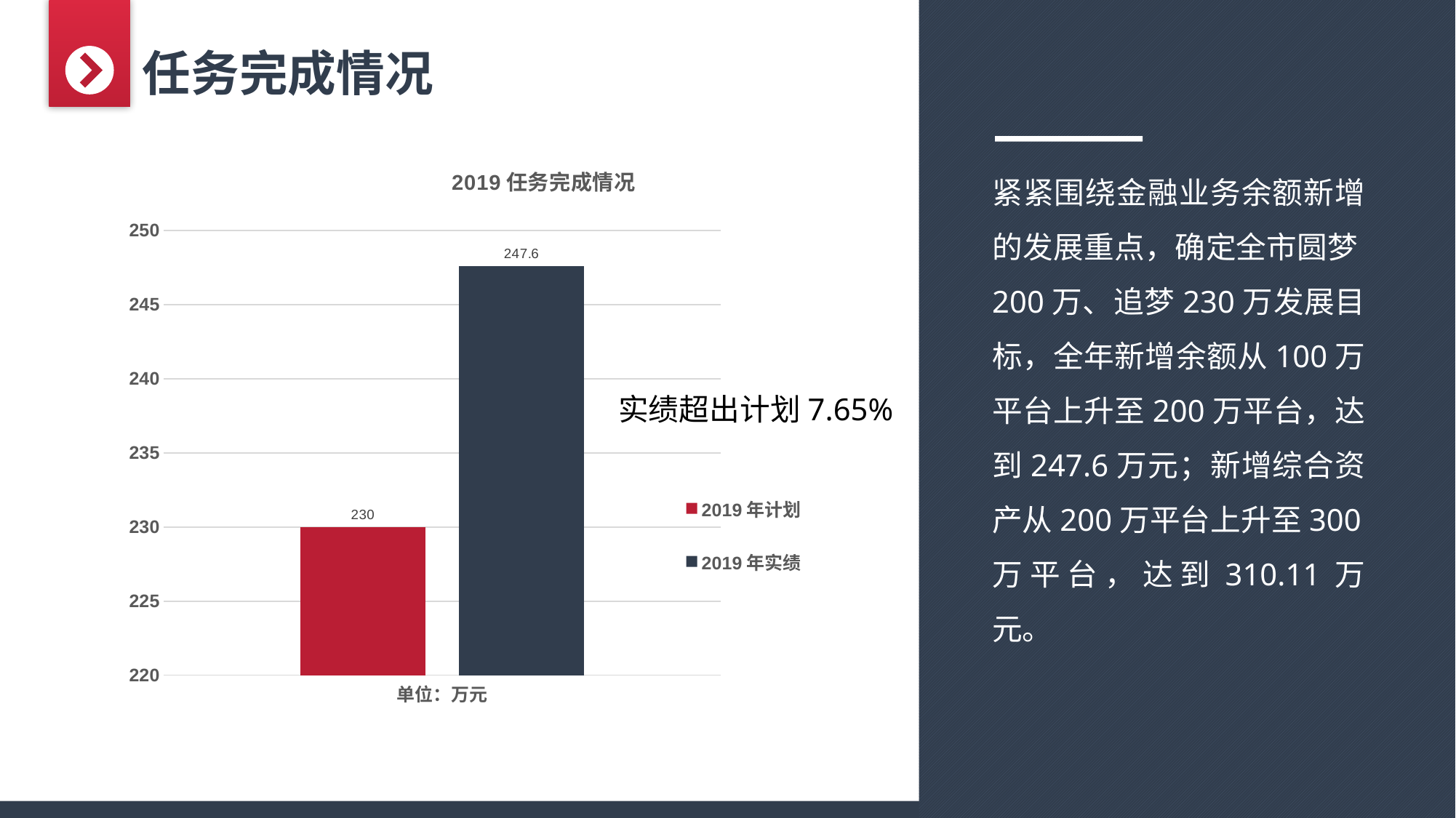
What colour is the bar for 2019 年计划? red Is the value for 2019 年计划 greater or less than 235? less Which series has the higher value, 2019 年计划 or 2019 年实绩? 2019 年实绩 What is the value for 2019 年实绩? 247.6 What is the value for 2019 年计划? 230 How many series does the legend list? 2 What is the difference between the 2019 年实绩 value and the 2019 年计划 value? 17.6 Is the value for 2019 年实绩 greater or less than 245? greater How many bars are plotted in the chart? 2 Which series has the lowest value? 2019 年计划 What kind of chart is shown? bar chart What is the title of the chart? 2019 任务完成情况